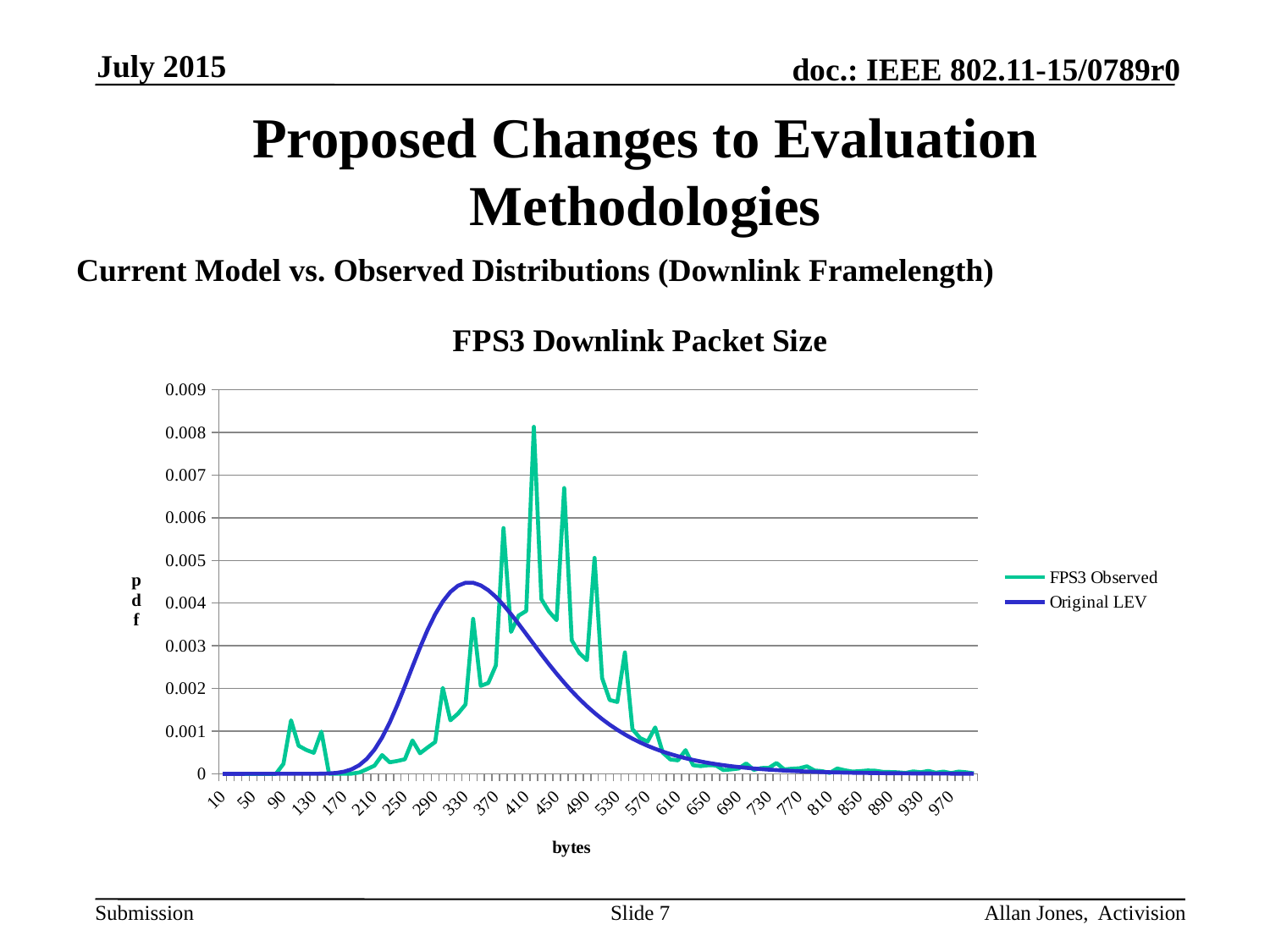
Is the peak value of the Original LEV series greater or less than 0.005? less What kind of chart is shown on the slide? line chart What is the label of the horizontal axis of the chart? bytes Which series reaches the higher peak value, FPS3 Observed or Original LEV? FPS3 Observed At 450 bytes, which series has the higher value, FPS3 Observed or Original LEV? FPS3 Observed What are the two series named in the legend of the chart? FPS3 Observed and Original LEV Is the peak value of the Original LEV series greater or less than 0.004? greater How many series does the legend of the FPS3 Downlink Packet Size chart list? 2 At 330 bytes, which series has the higher value, FPS3 Observed or Original LEV? Original LEV Is the value of the FPS3 Observed series at 90 bytes greater or less than 0.002? less Does the Original LEV series rise or fall as bytes increase from 170 to 330? rise